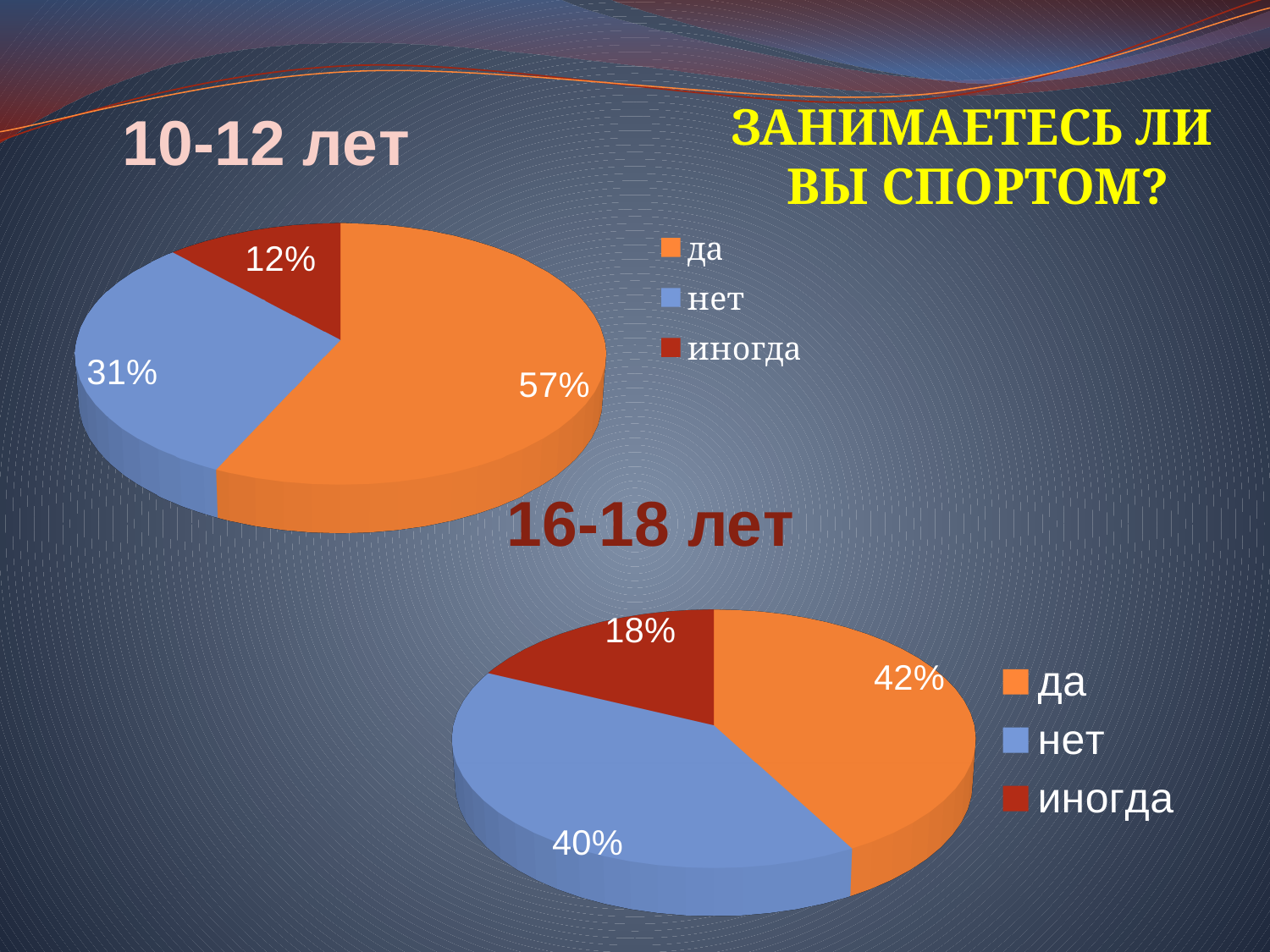
In the "10-12 лет" pie chart, what share is labelled for "нет"? 31% In the "16-18 лет" pie chart, what share is labelled for "нет"? 40% In the "16-18 лет" pie chart, what share is labelled for "да"? 42% How many categories does the legend of the "10-12 лет" chart list? 3 In the "10-12 лет" pie chart, what share is labelled for "иногда"? 12% Which chart has the larger share for "иногда", "10-12 лет" or "16-18 лет"? 16-18 лет In the "10-12 лет" pie chart, what share is labelled for "да"? 57% In the "10-12 лет" pie chart, which category has the largest slice? да In the "10-12 лет" pie chart, what is the difference between the shares for "да" and "нет"? 26% In the "16-18 лет" pie chart, which category has the smallest slice? иногда In the "16-18 лет" pie chart, what share is labelled for "иногда"? 18% What type of chart is the "16-18 лет" chart? Pie chart